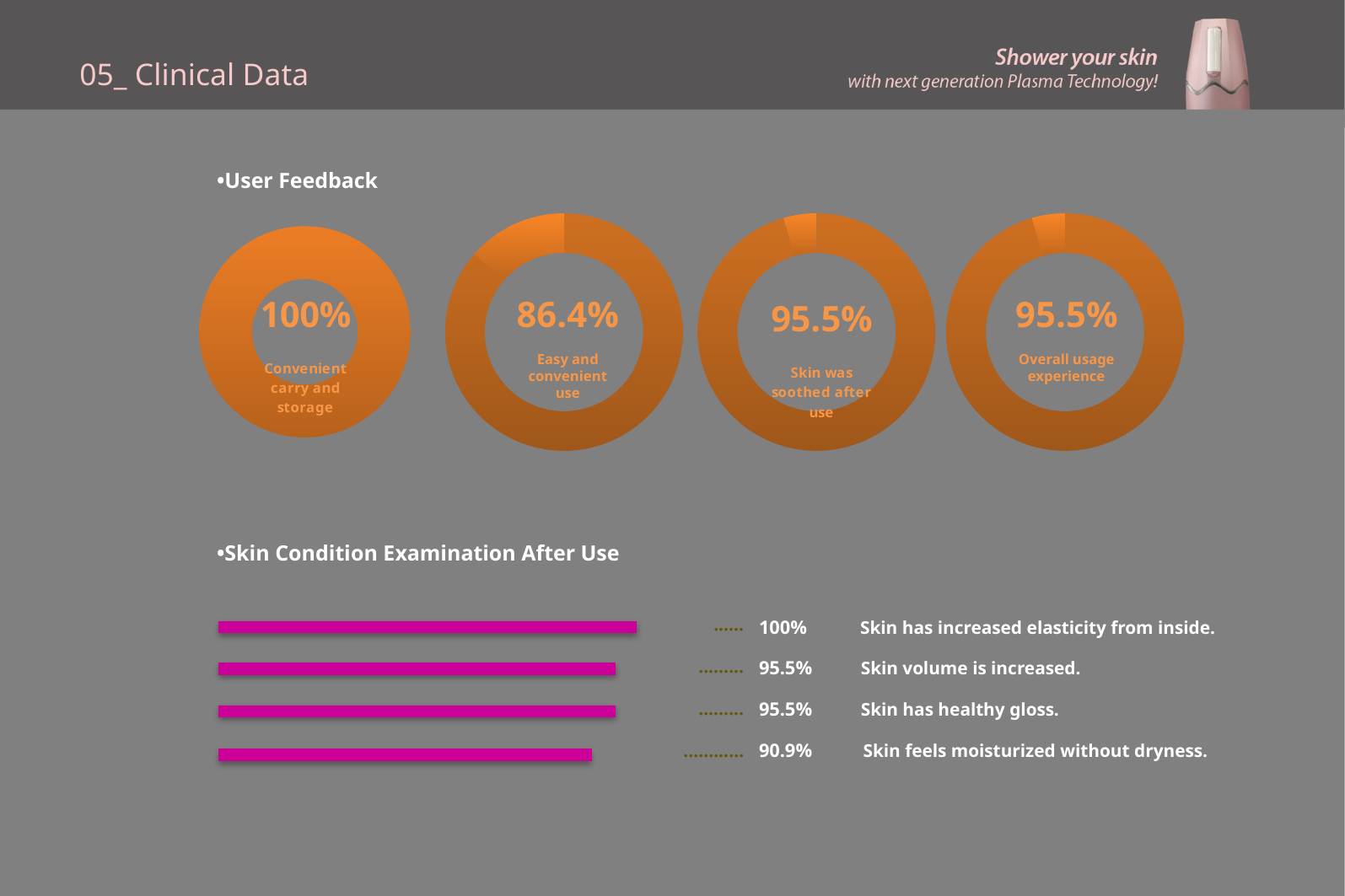
In the User Feedback section, what is the difference between the percentages for "Convenient carry and storage" and "Easy and convenient use"? 13.6% In the User Feedback section, which item has the lowest percentage? Easy and convenient use In the Skin Condition Examination After Use chart, how many bars are shown? 4 In the Skin Condition Examination After Use chart, which item has the highest percentage? Skin has increased elasticity from inside. In the Skin Condition Examination After Use chart, which is larger: the value for "Skin has healthy gloss." or "Skin feels moisturized without dryness."? Skin has healthy gloss. In the User Feedback section, what percentage is shown for "Convenient carry and storage"? 100% What kind of chart is used in the Skin Condition Examination After Use section? Bar chart In the User Feedback section, what percentage is shown for "Easy and convenient use"? 86.4% In the User Feedback section, how many donut charts are shown? 4 In the User Feedback section, what percentage is shown for "Overall usage experience"? 95.5% In the Skin Condition Examination After Use chart, what percentage is shown for "Skin volume is increased."? 95.5% In the Skin Condition Examination After Use chart, what percentage is shown for "Skin feels moisturized without dryness."? 90.9%